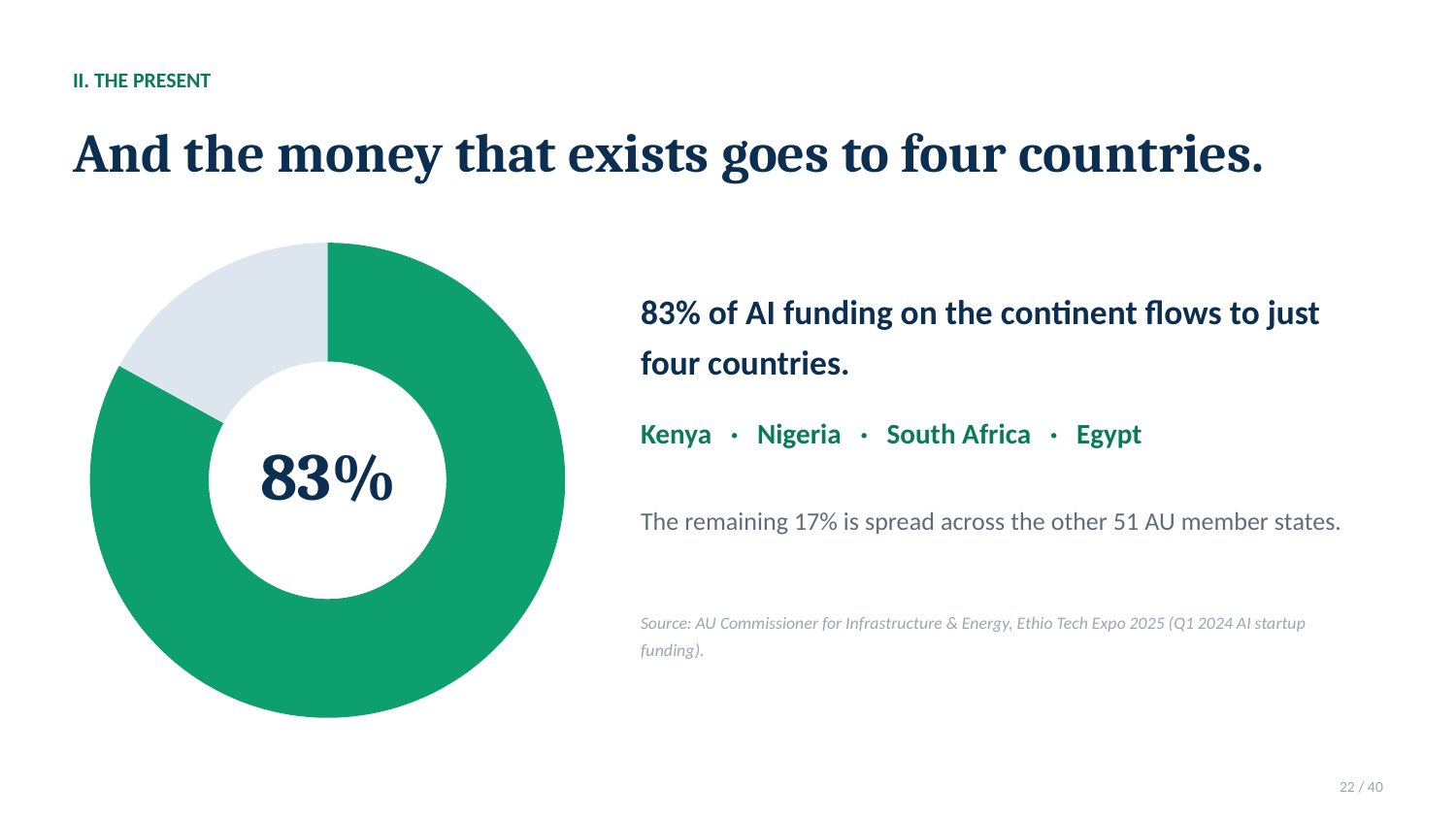
How many slices does the donut chart have? 2 Is the green slice of the donut chart greater or less than 50%? greater What colour is the slice representing the four countries' share of AI funding? green Which four countries does the slide name as receiving 83% of AI funding? Kenya, Nigeria, South Africa, Egypt Which group receives the smallest share of AI funding in the chart? the other 51 AU member states (17%) What kind of chart is shown on the slide? donut chart What is the difference in percentage points between the four countries' share and the remaining share? 66 percentage points What share of AI funding on the continent goes to the four countries, according to the chart? 83% Which slice of the donut chart is larger, the green one or the light grey one? the green one What share of AI funding is spread across the other 51 AU member states? 17% What percentage is printed in the centre of the donut chart? 83% Which group receives the largest share of AI funding in the chart? the four countries (83%)